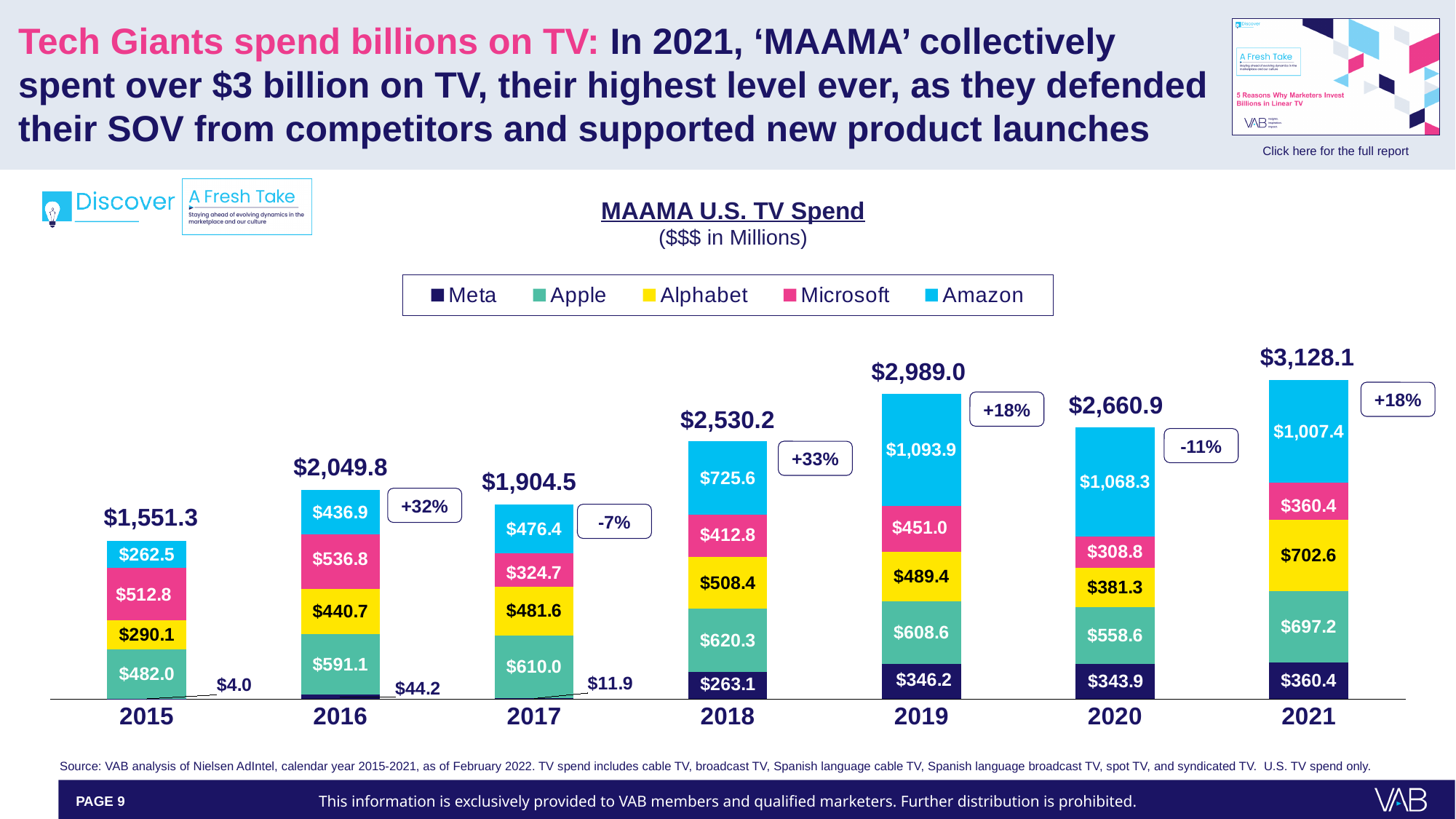
How many series does the legend list? 5 What was Alphabet's U.S. TV spend in 2021? $702.6 What type of chart is shown on the slide? Stacked bar chart What was Meta's U.S. TV spend in 2015? $4.0 What is the total MAAMA U.S. TV spend for 2021? $3,128.1 What is the difference between Apple's spend in 2021 and in 2020? $138.6 How many years are shown on the x axis? 7 Which was larger in 2017, Apple's spend or Microsoft's spend? Apple What percentage change in total spend is shown for 2020 versus 2019? -11% What was Amazon's U.S. TV spend in 2019? $1,093.9 Which year has the lowest total MAAMA U.S. TV spend? 2015 Which year has the highest total MAAMA U.S. TV spend? 2021